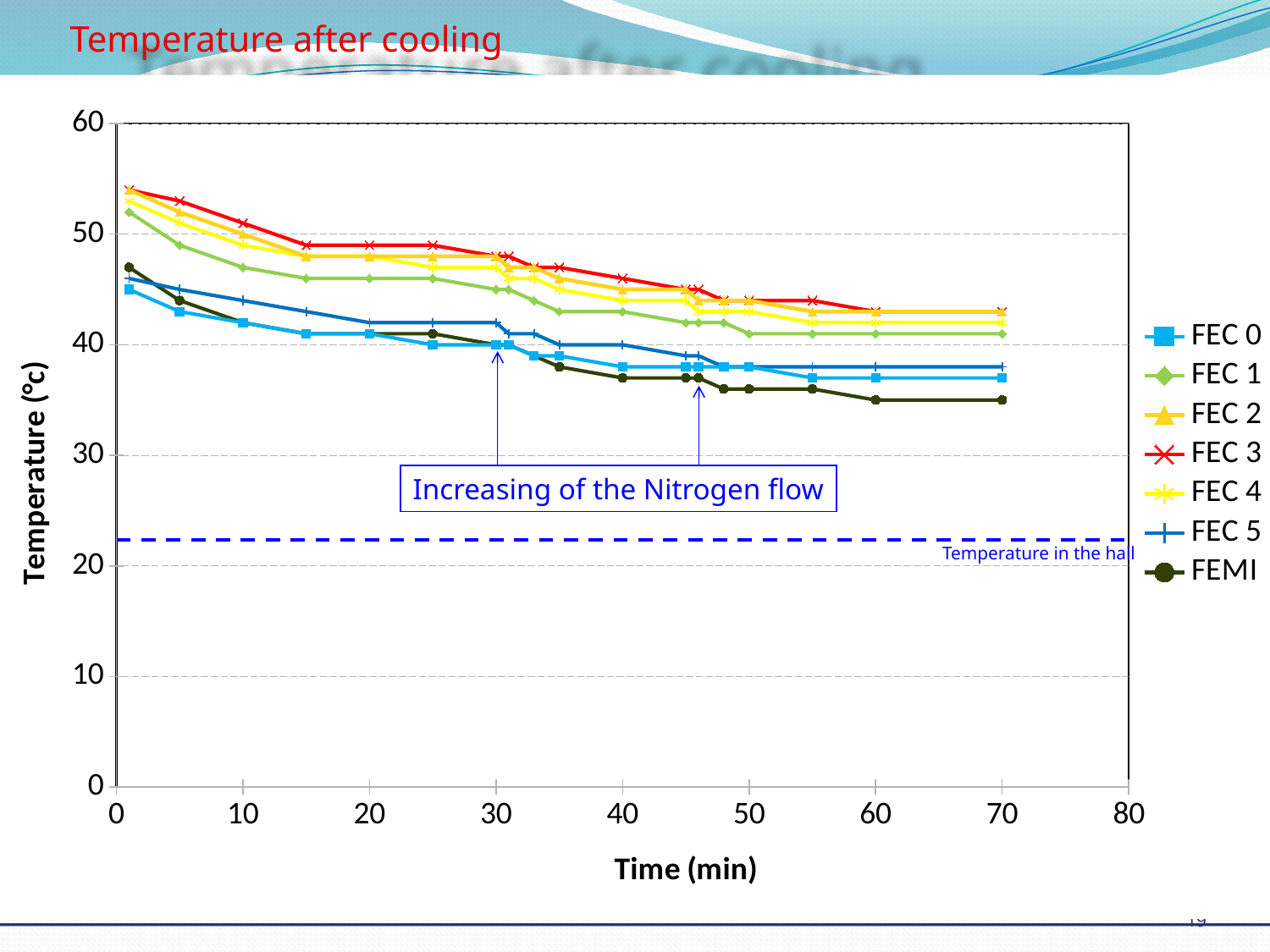
At 70 min, which is higher, FEC 3 or FEMI? FEC 3 What kind of chart is shown on the slide? line chart Is the value for FEC 2 at 70 min greater or less than 40? greater Is the value for FEC 3 at the start of the measurement greater or less than 50? greater How many series does the legend list? 7 Is the value for FEMI at 70 min greater or less than 40? less What is the title of the chart? Temperature after cooling Do the temperature values rise or fall as time increases? fall At the start of the measurement, which is higher, FEC 0 or FEC 3? FEC 3 What does the dashed blue horizontal line represent? Temperature in the hall Which series has the lowest temperature at 70 min? FEMI